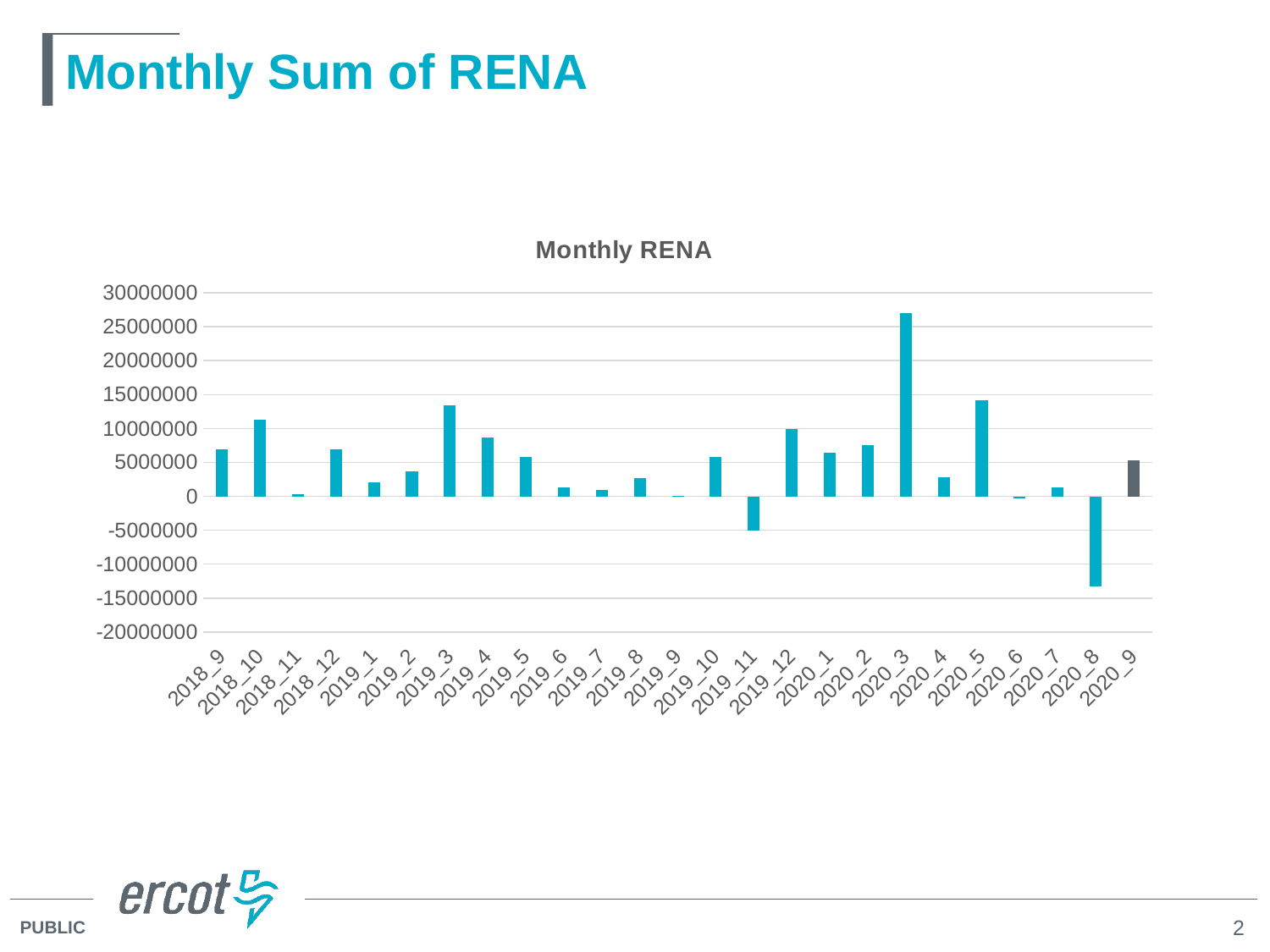
Is the value for 2019_6 greater or less than 5000000? less What kind of chart is shown on the slide? bar chart Which month has the lowest Monthly RENA value? 2020_8 Is the value for 2019_11 greater or less than 0? less Which is larger, the value for 2020_3 or the value for 2020_5? 2020_3 Which month has the highest Monthly RENA value? 2020_3 Is the value for 2020_8 greater or less than -10000000? less How many months (categories) are plotted on the x axis? 25 What is the title of the chart? Monthly RENA Which bar is drawn in a different colour (dark grey) from the rest? 2020_9